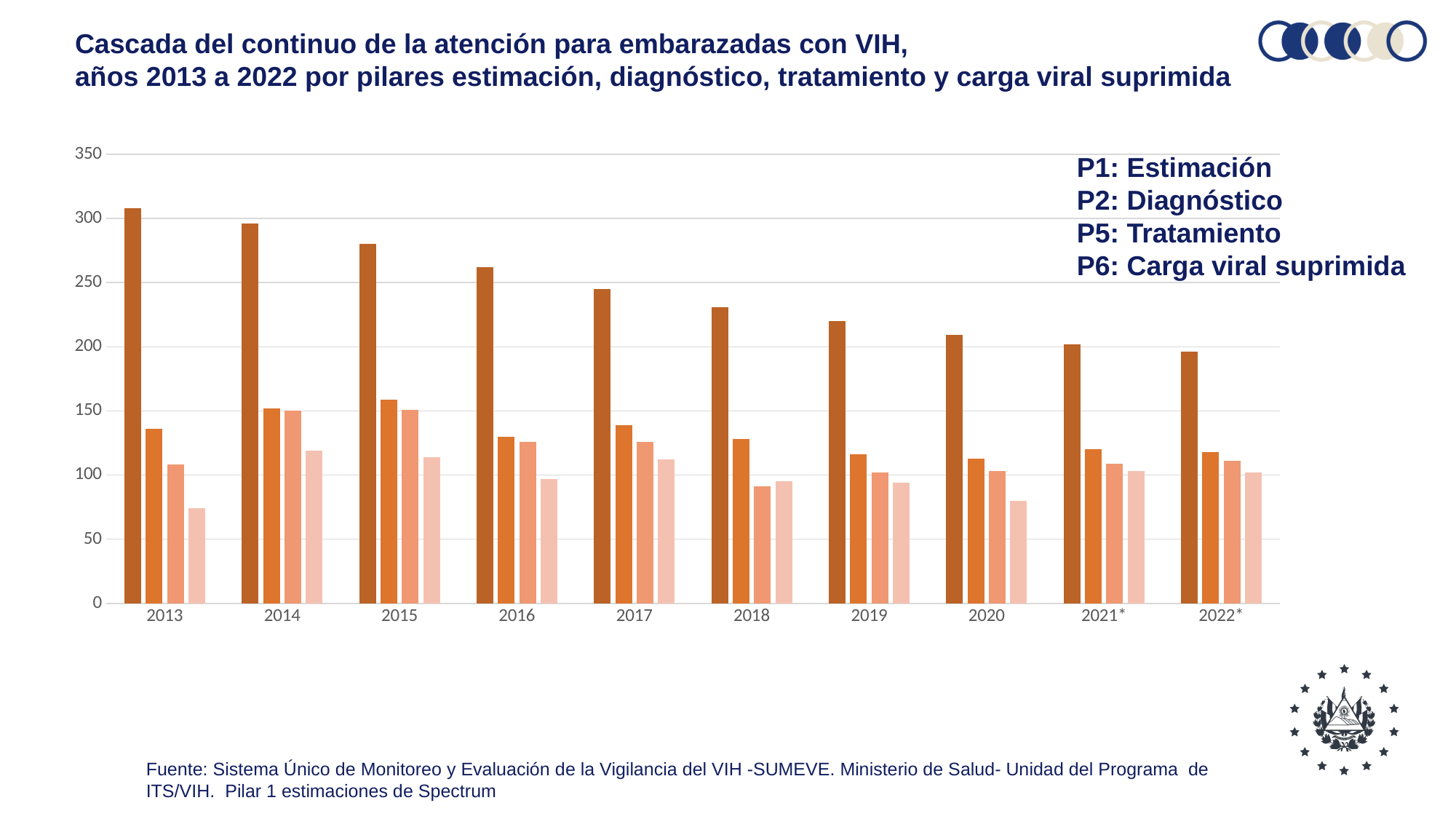
What kind of chart is shown on the slide? bar chart Is the value of the first (darkest) bar for 2022* greater or less than 200? less Which year has the larger fourth (lightest) bar, 2013 or 2014? 2014 Is the value of the first (darkest) bar for 2013 greater or less than 300? greater In which year is the first (darkest) bar the lowest? 2022* Is the value of the first (darkest) bar for 2018 greater or less than 250? less How many bars are plotted for each year in the chart? 4 Does the first (darkest) bar rise or fall from 2013 to 2022*? fall How many years are shown along the x axis of the chart? 10 In which year is the first (darkest) bar the highest? 2013